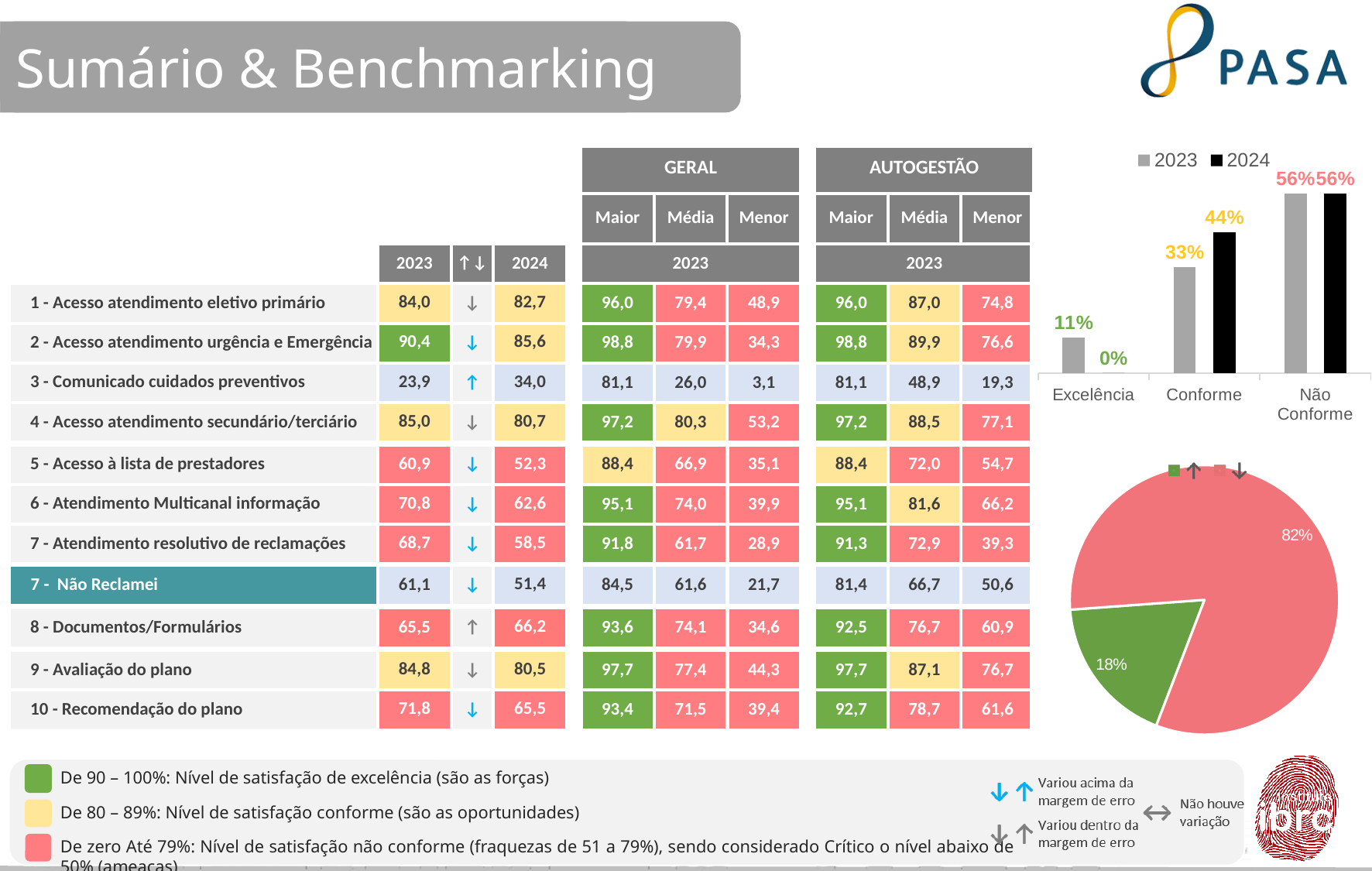
In the bar chart at the top right, how many series does the legend list? 2 In the bar chart at the top right, which category has the lowest 2023 value? Excelência In the bar chart at the top right, which category has the highest 2024 value? Não Conforme In the bar chart at the top right, what is the 2024 value for Conforme? 44% In the bar chart at the top right, what is the 2023 value for Excelência? 11% In the pie chart at the bottom right, what share does the largest (red) slice represent? 82% What kind of chart is shown at the bottom right of the slide? Pie chart In the bar chart at the top right, what is the 2024 value for Excelência? 0% In the bar chart at the top right, how many categories are shown on the x axis? 3 In the bar chart at the top right, which is larger for Excelência: the 2023 value or the 2024 value? 2023 In the bar chart at the top right, what is the 2023 value for Não Conforme? 56% In the bar chart at the top right, what is the difference between the 2024 and 2023 values for Conforme? 11%